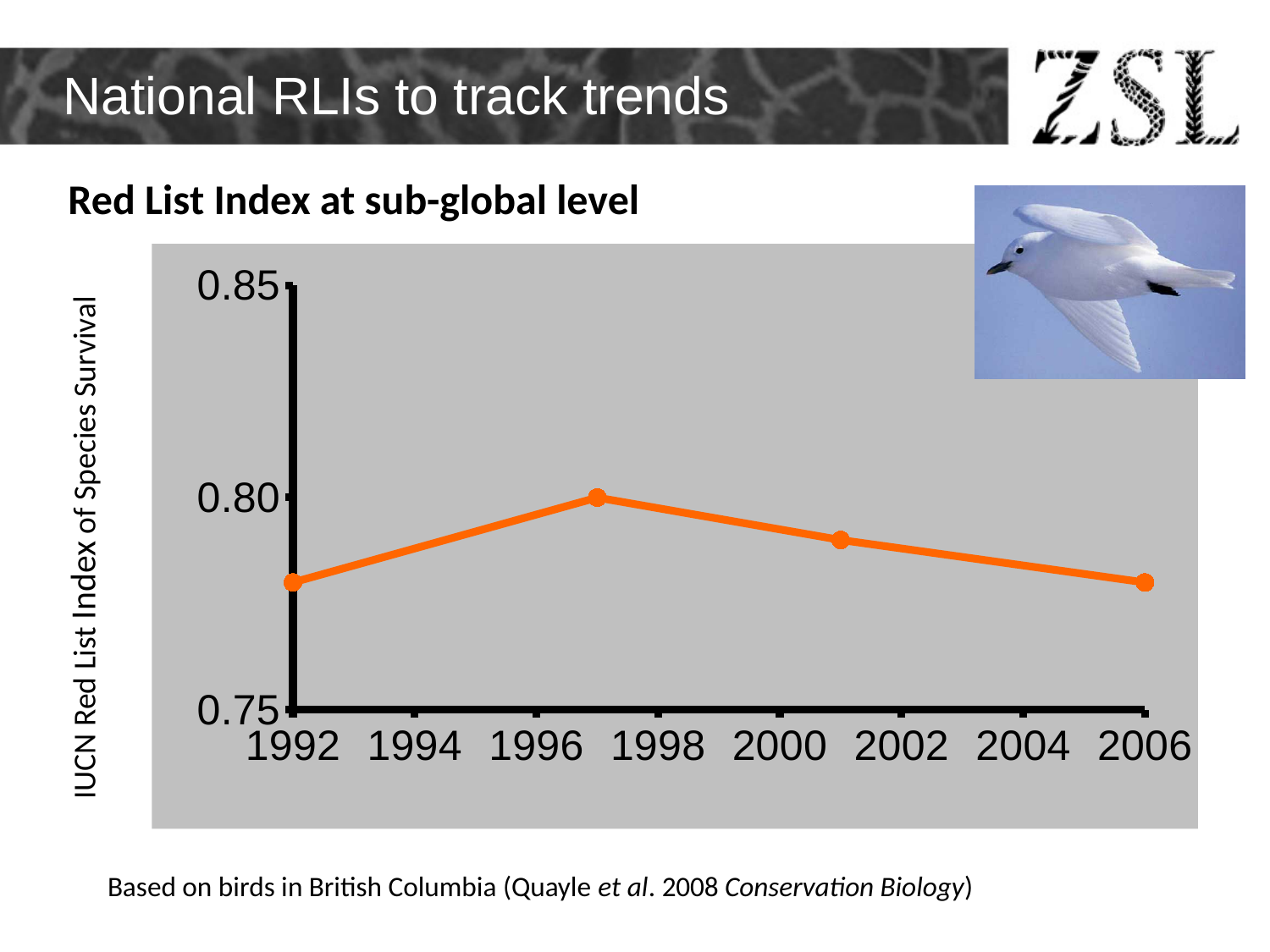
Around which year does the line reach its highest point? 1997 What is the highest value shown on the vertical axis? 0.85 Does the line rise or fall between its peak around 1997 and 2006? fall Is the value for 1992 greater or less than 0.80? less Which is larger, the value for 1992 or the peak value around 1997? the peak value around 1997 Is the value for 1992 greater or less than 0.75? greater What value does the highest point on the line reach? 0.80 Is the value for 2006 greater or less than 0.80? less Does the line rise or fall between 1992 and its peak around 1997? rise What kind of chart is shown on the slide? line chart What is the label of the vertical axis? IUCN Red List Index of Species Survival How many data points are plotted on the line? 4